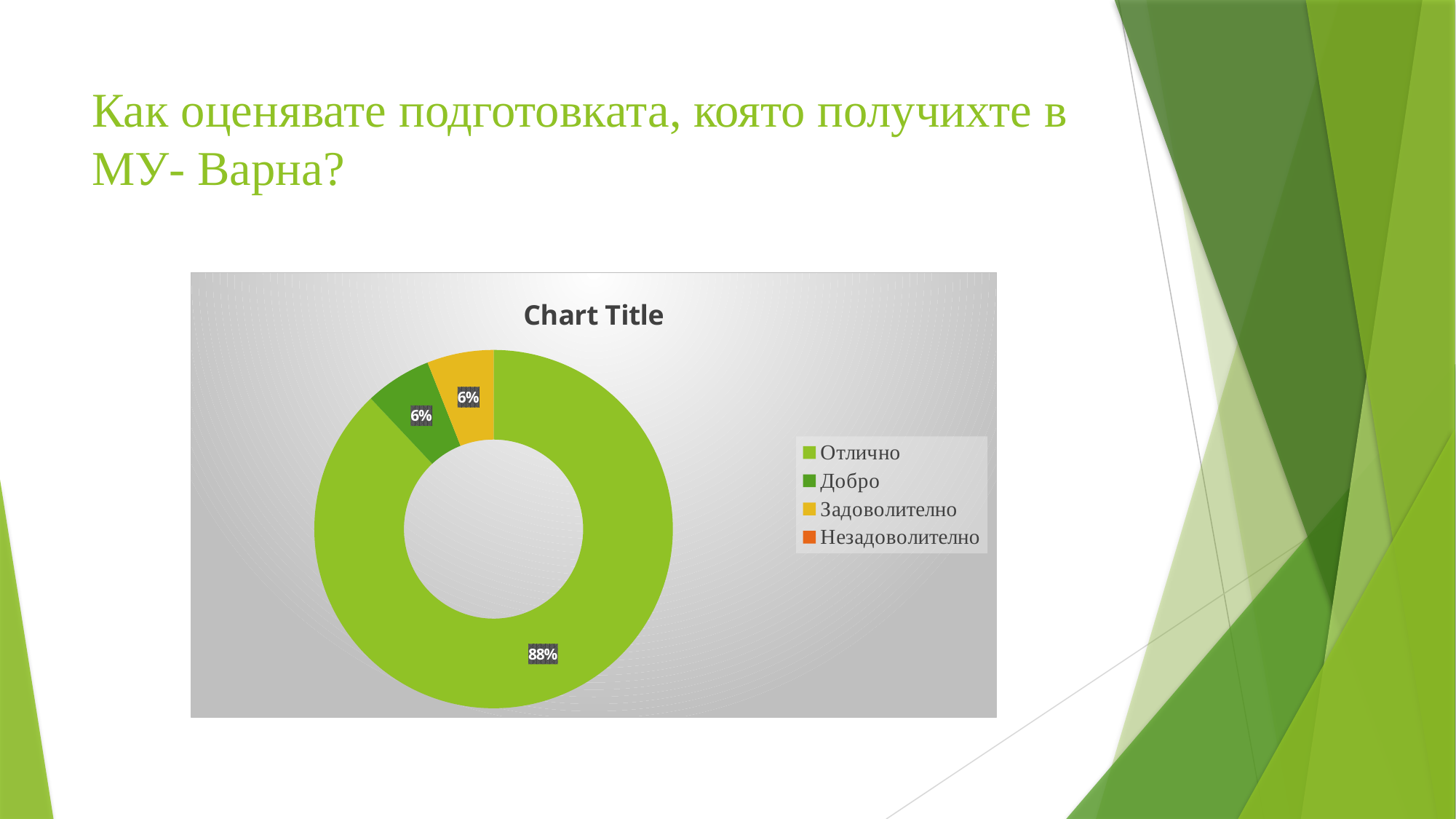
What is the difference in percentage points between Отлично and Задоволително? 82 How many slices with data labels are visible in the chart? 3 Which is larger, the share for Отлично or the share for Добро? Отлично What type of chart is shown on the slide? Doughnut chart Which category has the largest share of the chart? Отлично What percentage is shown for Отлично? 88% What percentage is shown for Задоволително? 6% What percentage is shown for Добро? 6% How many entries does the legend list? 4 Which legend entry is shown in orange? Незадоволително Is the share for Отлично greater or less than 50%? greater What is the title shown on the chart? Chart Title